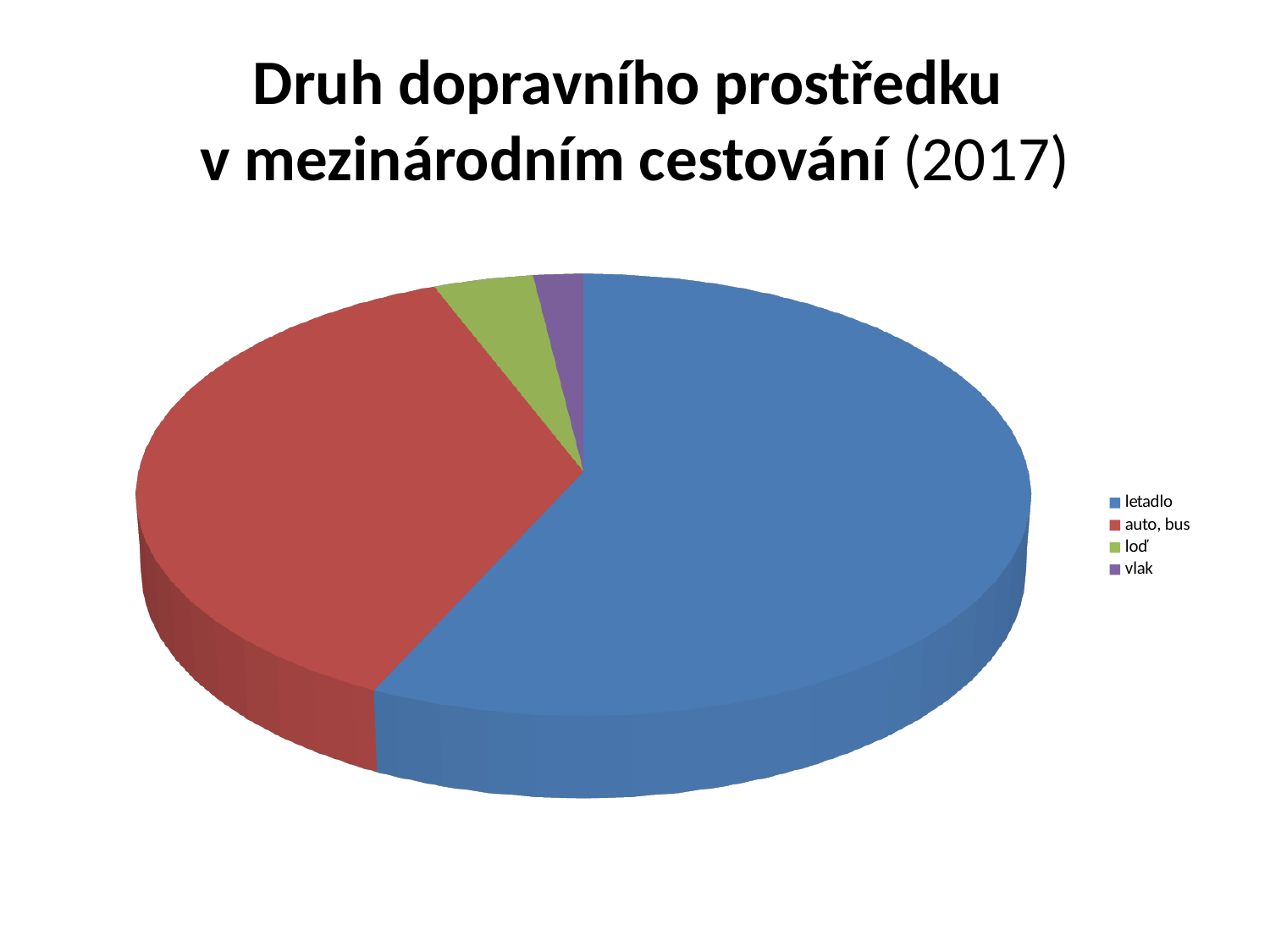
Which category has the smallest slice of the pie? vlak What kind of chart is shown on the slide? pie chart What is the title of the chart? Druh dopravního prostředku v mezinárodním cestování (2017) What colour is the slice for letadlo? blue Which slice is larger, auto, bus or loď? auto, bus How many entries does the legend list? 4 Which slice is larger, letadlo or auto, bus? letadlo How many categories does the pie chart show? 4 Which category has the second largest slice of the pie? auto, bus Which category has the largest slice of the pie? letadlo Which slice is larger, loď or vlak? loď